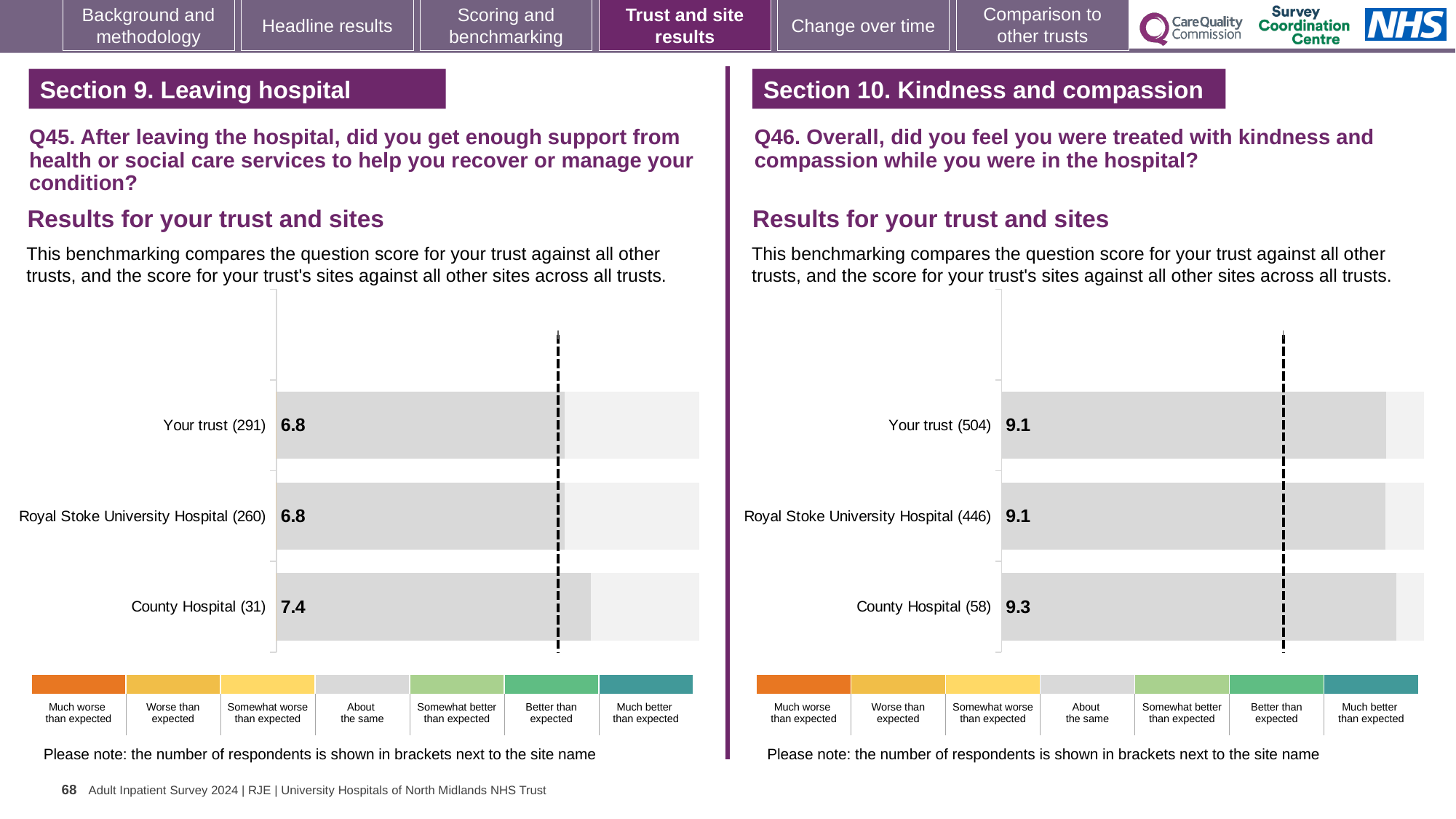
What kind of chart is used in the Q45 chart on the left? Bar chart In the Q45 chart on the left, what is the score for County Hospital? 7.4 In the Q45 chart on the left, what is the difference between the County Hospital score and the Royal Stoke University Hospital score? 0.6 In the Q46 chart on the right, which site or trust has the highest score? County Hospital In the Q46 chart on the right, is the score for County Hospital larger or smaller than the score for Your trust? larger In the Q45 chart on the left, which site or trust has the highest score? County Hospital In the Q46 chart on the right, what is the difference between the County Hospital score and the Your trust score? 0.2 In the Q46 chart on the right, how many respondents are shown in brackets for Your trust? 504 In the Q45 chart on the left, how many bars are plotted? 3 In the Q46 chart on the right, what is the score for Royal Stoke University Hospital? 9.1 In the Q46 chart on the right, what is the score for County Hospital? 9.3 In the Q45 chart on the left, what is the score for Your trust? 6.8